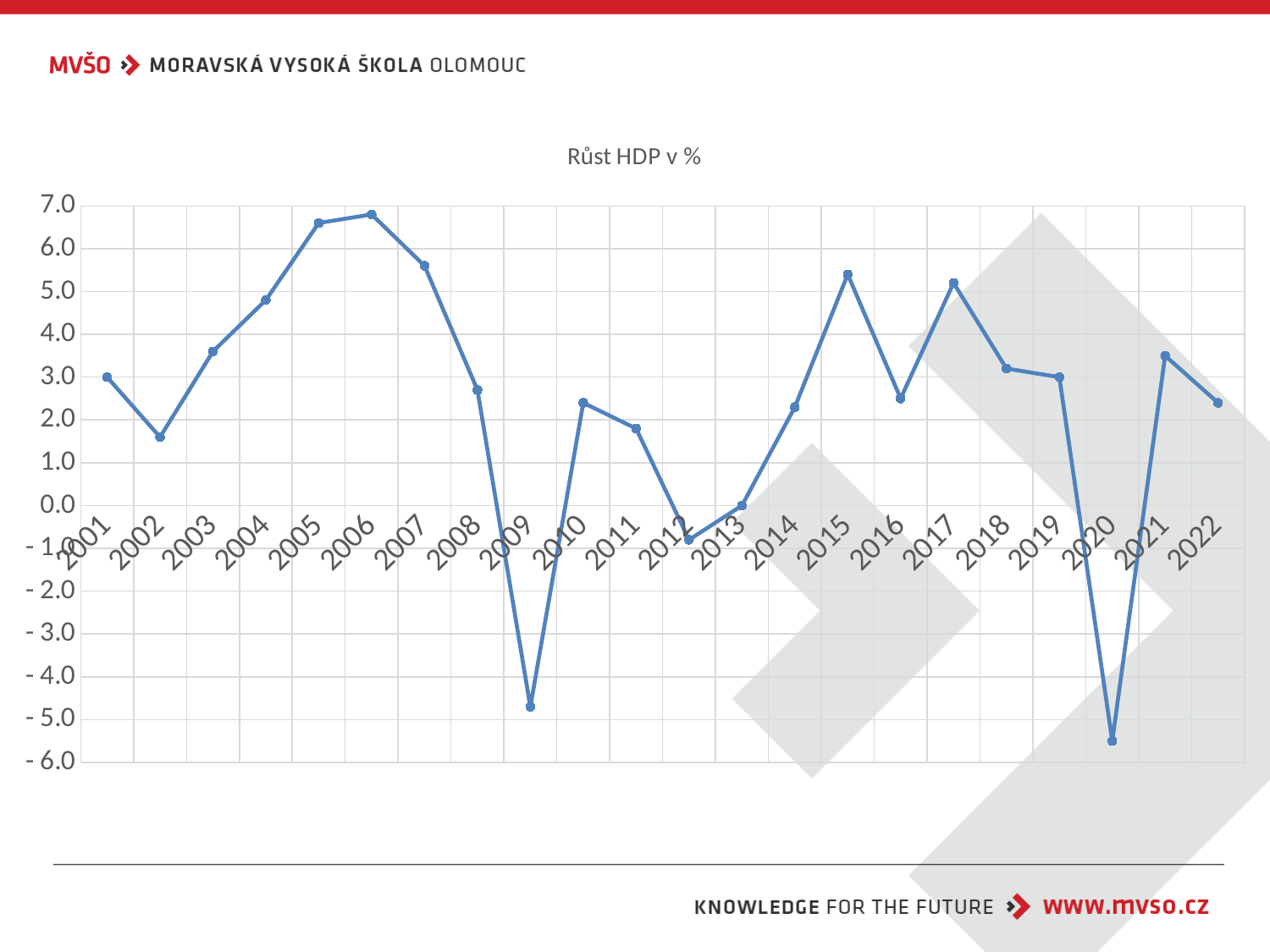
Is the value for 2005 greater or less than 6.0? greater Is the value for 2020 greater or less than -5.0? less Do the values rise or fall from 2006 to 2009? fall Is the value for 2012 greater or less than 0.0? less Which year has the lowest value in the chart? 2020 What kind of chart is shown on the slide? line chart Which year has the highest value in the chart? 2006 How many years are plotted on the x axis of the chart? 22 Which year has the larger value, 2006 or 2015? 2006 What is the title of the chart? Růst HDP v %